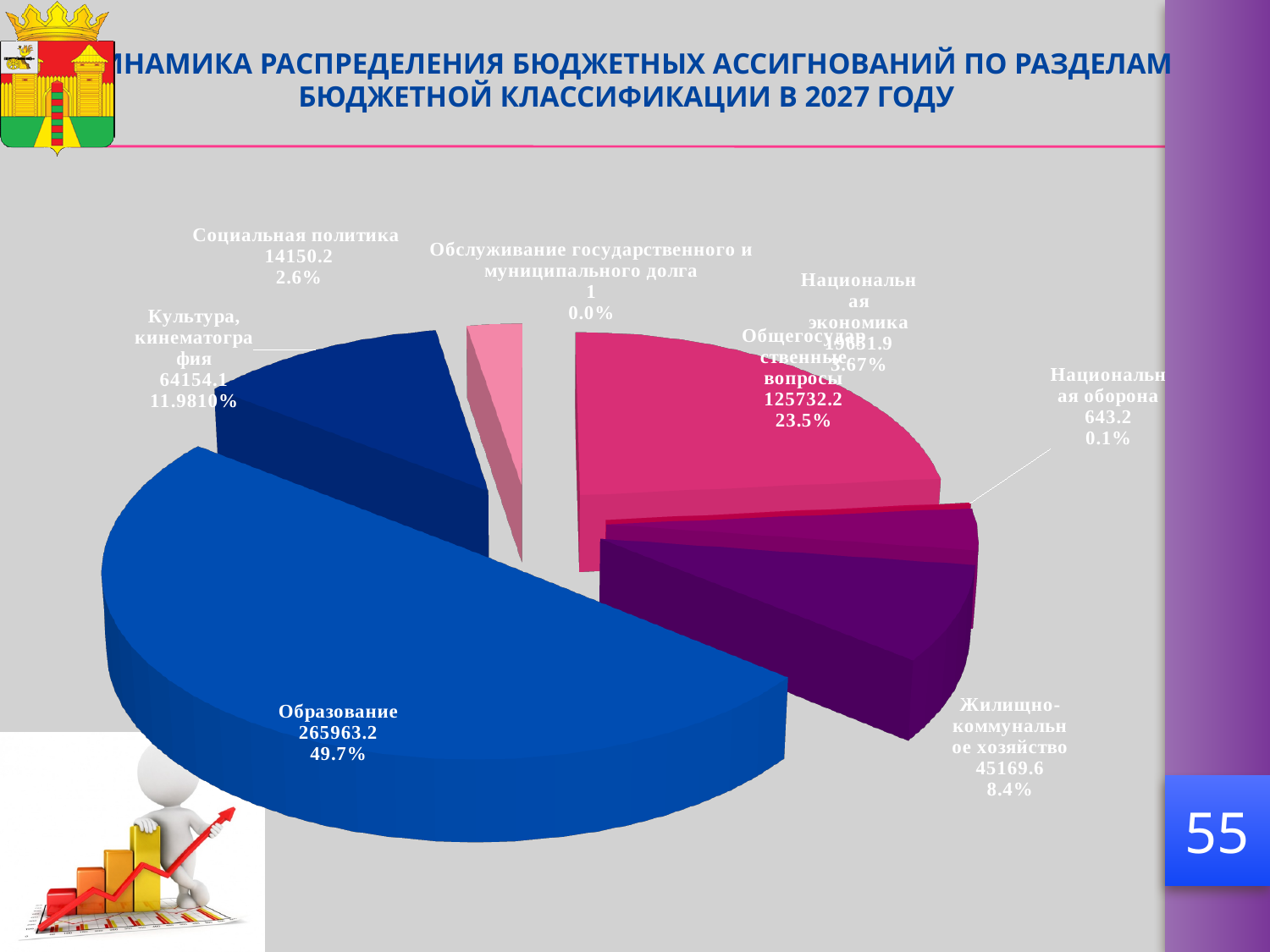
What percentage share does Образование have? 49.7% What percentage share does Жилищно-коммунальное хозяйство have? 8.4% Which category has the smallest value in the pie chart? Обслуживание государственного и муниципального долга What is the value shown for Образование? 265963.2 What kind of chart is shown on the slide? pie chart Which category has the largest share of the pie? Образование How many categories (slices) does the pie chart show? 8 What is the value shown for Национальная оборона? 643.2 What is the value shown for Общегосударственные вопросы? 125732.2 Which is larger, the value for Культура, кинематография or the value for Жилищно-коммунальное хозяйство? Культура, кинематография What is the difference between the values for Образование and Общегосударственные вопросы? 140231.0 What is the value shown for Социальная политика? 14150.2